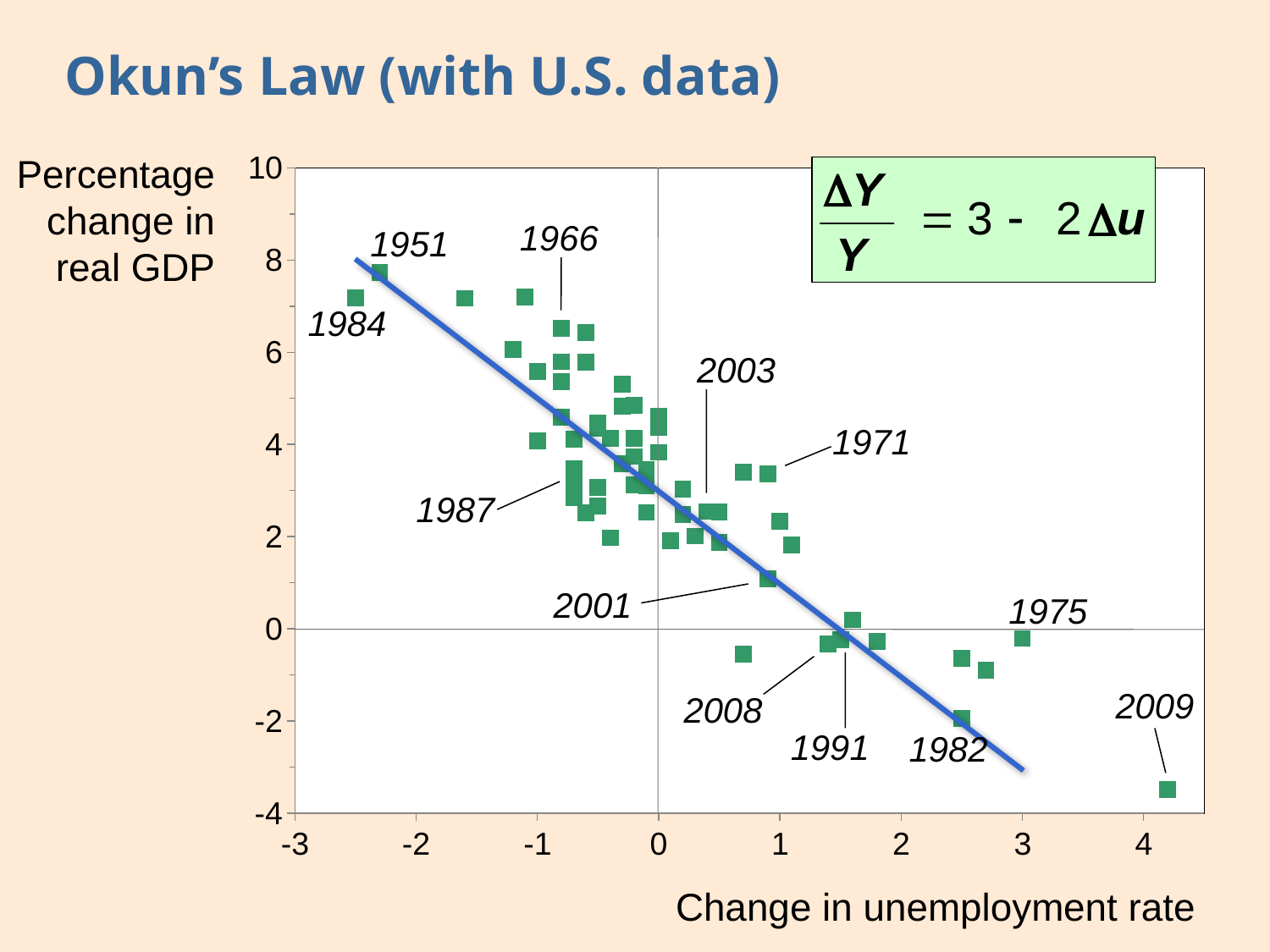
Is the percentage change in real GDP for the point labeled 1951 greater or less than 6? greater What is the label of the horizontal axis? Change in unemployment rate Is the change in unemployment rate for the point labeled 2009 greater or less than 3? greater Is the change in unemployment rate for the point labeled 1984 greater or less than -1? less What kind of chart is shown on the slide? Scatter plot Which labeled year has the lowest percentage change in real GDP? 2009 As the change in unemployment rate increases along the x axis, does the percentage change in real GDP generally rise or fall? Fall Which has the larger percentage change in real GDP, the point labeled 1966 or the point labeled 2003? 1966 Which labeled year has the highest percentage change in real GDP? 1951